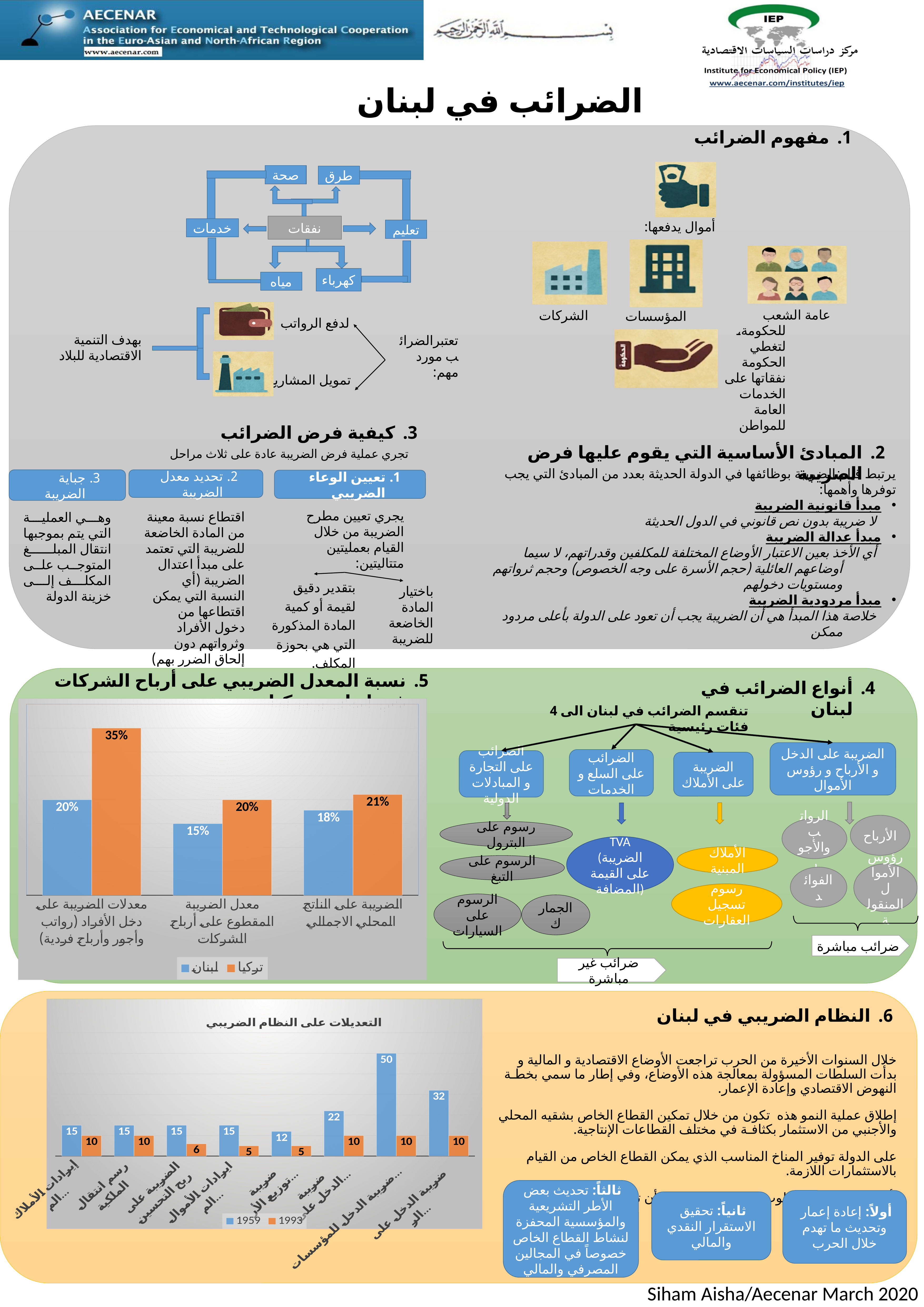
In the chart titled 'التعديلات على النظام الضريبي', what is the 1993 value for الضريبة على ربح التحسين? 6 In the chart titled 'التعديلات على النظام الضريبي', which category has the highest 1959 value? ضريبة الدخل للمؤسسات What type of chart is used in section 5 to compare لبنان and تركيا? bar chart In the chart titled 'التعديلات على النظام الضريبي', how many series does the legend list? 2 In the chart titled 'التعديلات على النظام الضريبي', how many categories are shown? 8 In the corporate tax rate chart in section 5, what is the value for لبنان for الضريبة على الناتج المحلي الاجمالي? 18% In the chart titled 'التعديلات على النظام الضريبي', what is the 1959 value for ضريبة الدخل للمؤسسات? 50 In the chart titled 'التعديلات على النظام الضريبي', what is the 1993 value for رسم انتقال الملكية? 10 In the corporate tax rate chart in section 5, which is larger for معدلات الضريبة على دخل الأفراد: لبنان or تركيا? تركيا In the corporate tax rate chart in section 5, what is the difference between تركيا and لبنان for معدلات الضريبة على دخل الأفراد? 15% In the corporate tax rate chart in section 5, what is the value for تركيا for معدل الضريبة المقطوع على أرباح الشركات? 20% In the chart titled 'التعديلات على النظام الضريبي', what is the difference between the 1959 and 1993 values for ضريبة الدخل للمؤسسات? 40